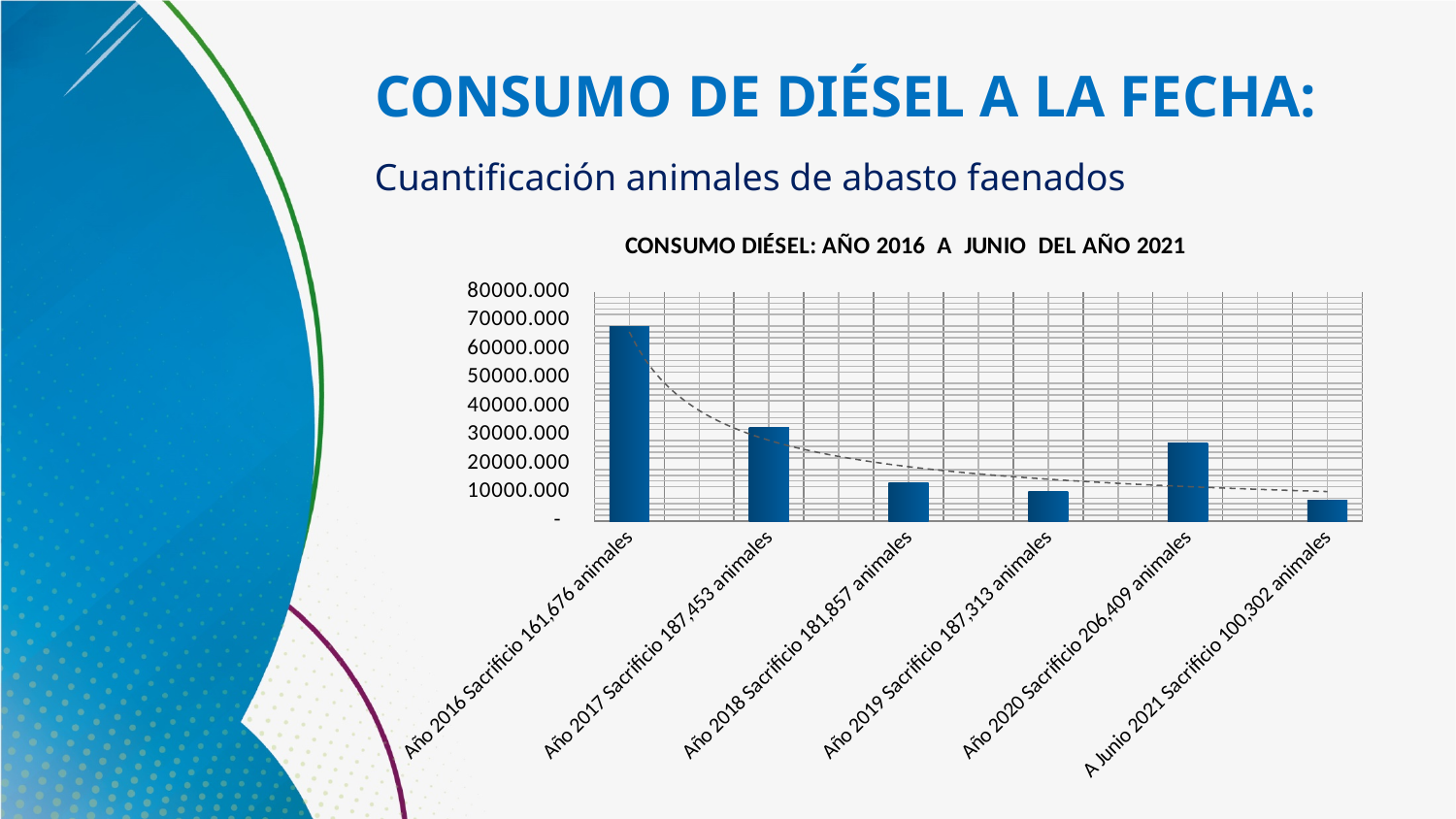
What kind of chart is shown on the slide? bar chart Which category has the highest diesel consumption? Año 2016 Sacrificio 161,676 animales How many categories (bars) does the chart show? 6 Is the value for A Junio 2021 Sacrificio 100,302 animales greater or less than 10000.000? less Which is larger, the value for Año 2017 Sacrificio 187,453 animales or the value for Año 2020 Sacrificio 206,409 animales? Año 2017 Sacrificio 187,453 animales Is the value for Año 2017 Sacrificio 187,453 animales greater or less than 20000.000? greater Is the value for Año 2019 Sacrificio 187,313 animales greater or less than 20000.000? less What is the title of the chart? CONSUMO DIÉSEL: AÑO 2016 A JUNIO DEL AÑO 2021 Does the dashed trend line on the chart rise or fall from left to right? fall